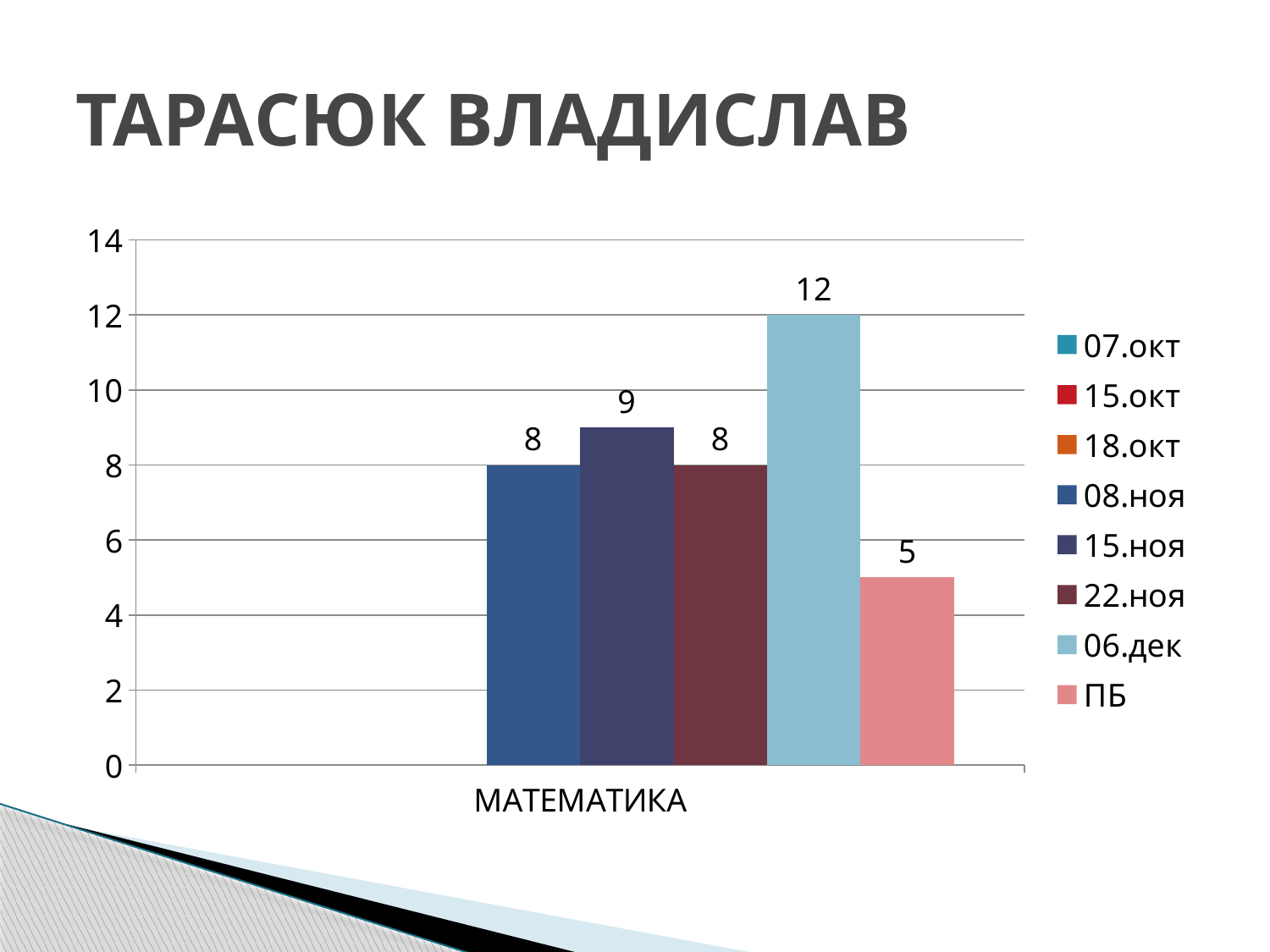
What is the value for ПБ in the МАТЕМАТИКА category? 5 What is the value for 08.ноя in the МАТЕМАТИКА category? 8 What is the difference between the values for 06.дек and ПБ? 7 What is the value for 15.ноя in the МАТЕМАТИКА category? 9 What is the value for 06.дек in the МАТЕМАТИКА category? 12 Which is larger, the value for 15.ноя or the value for 22.ноя? 15.ноя Which series with a visible bar has the lowest value in the МАТЕМАТИКА category? ПБ Which series has the highest value in the МАТЕМАТИКА category? 06.дек What is the title of the slide? ТАРАСЮК ВЛАДИСЛАВ What kind of chart is shown on the slide? bar chart How many series does the legend list? 8 Is the value for 06.дек greater or less than 10? greater